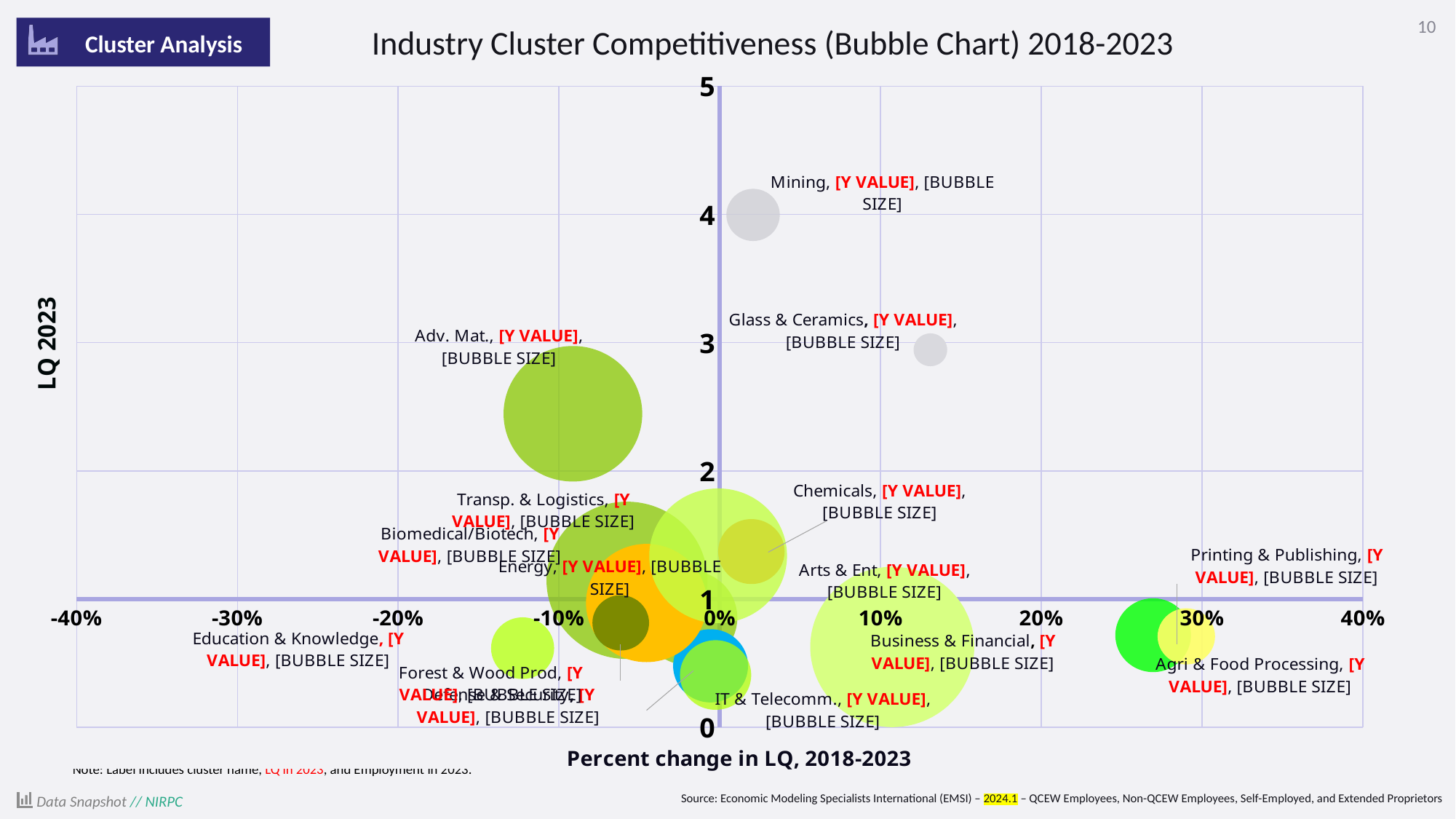
Is the LQ 2023 value for Adv. Mat. greater or less than 2? greater Which cluster has the highest LQ 2023 value? Mining Is the LQ 2023 value for Mining greater or less than 3? greater Is the percent change in LQ for Printing & Publishing greater or less than 20%? greater Which has the higher LQ 2023 value, Mining or Glass & Ceramics? Mining Which has the higher LQ 2023 value, Adv. Mat. or Arts & Ent? Adv. Mat. What is the title of the vertical axis? LQ 2023 What kind of chart is shown on the slide? Bubble chart What is the title of the chart? Industry Cluster Competitiveness (Bubble Chart) 2018-2023